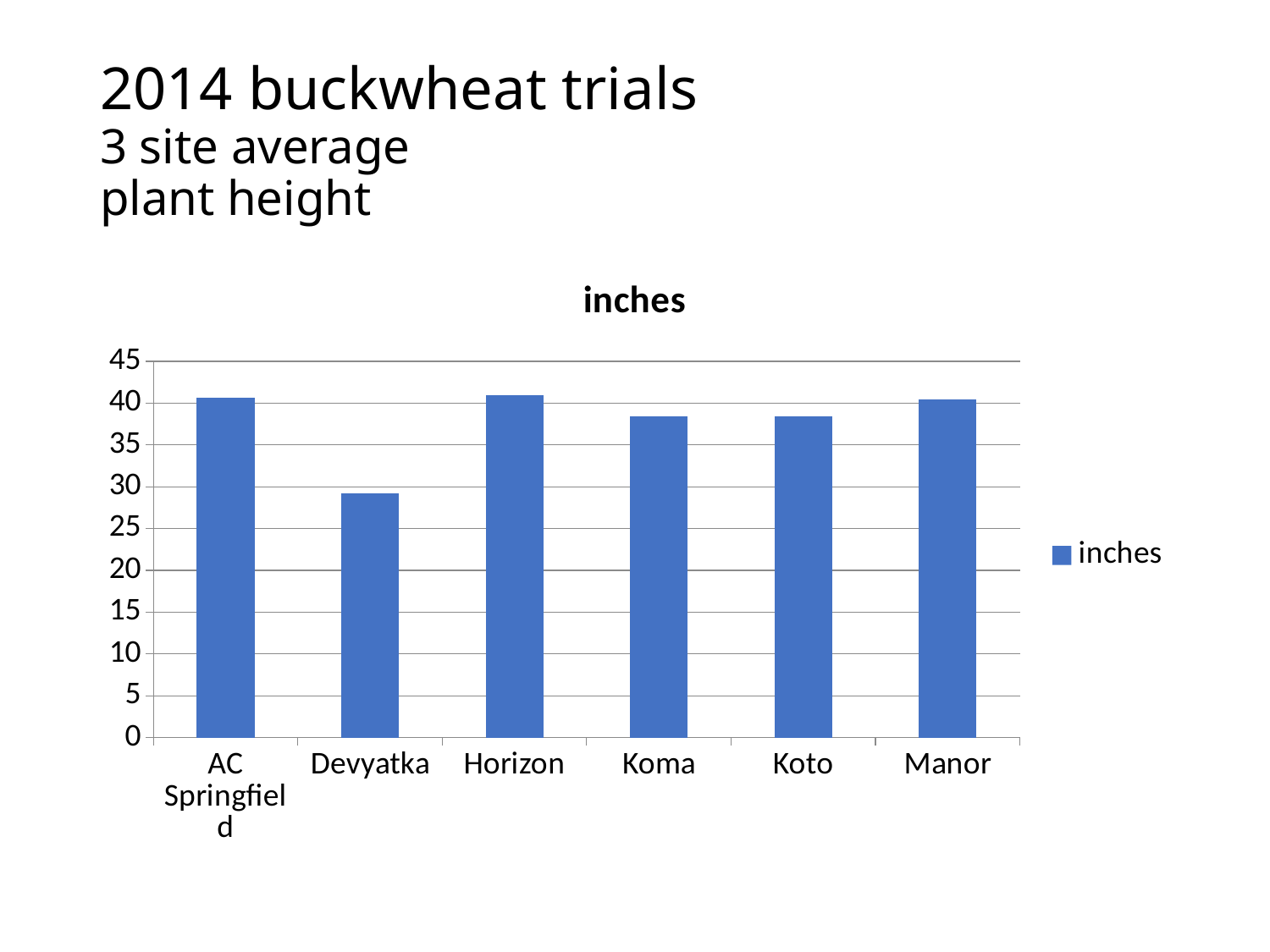
Is the value for Horizon greater or less than 40? greater Which is larger, the value for Horizon or the value for Koto? Horizon How many buckwheat varieties are shown on the x axis of the chart? 6 How many series does the chart's legend list? 1 What is the title of the chart? inches Is the value for Koto greater or less than 35? greater Is the value for Devyatka greater or less than 30? less What kind of chart is shown on the slide? bar chart Which is larger, the value for Devyatka or the value for Koma? Koma Which variety has the lowest plant height in the chart? Devyatka